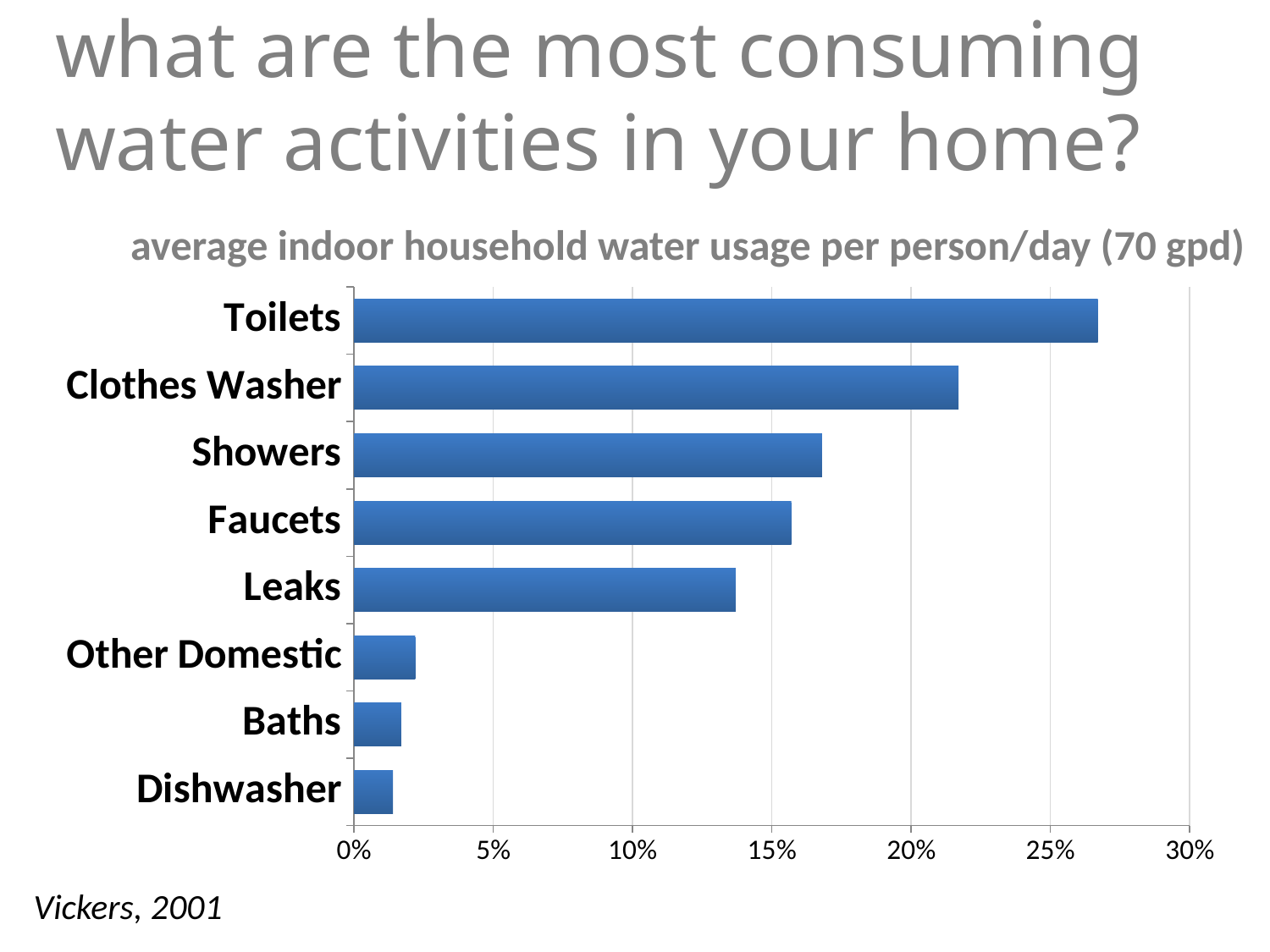
Is the value for Other Domestic greater or less than 5%? less What kind of chart is shown on the slide? bar chart Is the value for Toilets greater or less than 25%? greater Which category has the lowest water usage share? Dishwasher Which category has the highest water usage share? Toilets Is the value for Clothes Washer greater or less than 20%? greater Which has a larger value, Leaks or Faucets? Faucets What is the title of the chart? average indoor household water usage per person/day (70 gpd) What source is cited below the chart? Vickers, 2001 How many categories are plotted in the chart? 8 Which has a larger value, Toilets or Clothes Washer? Toilets